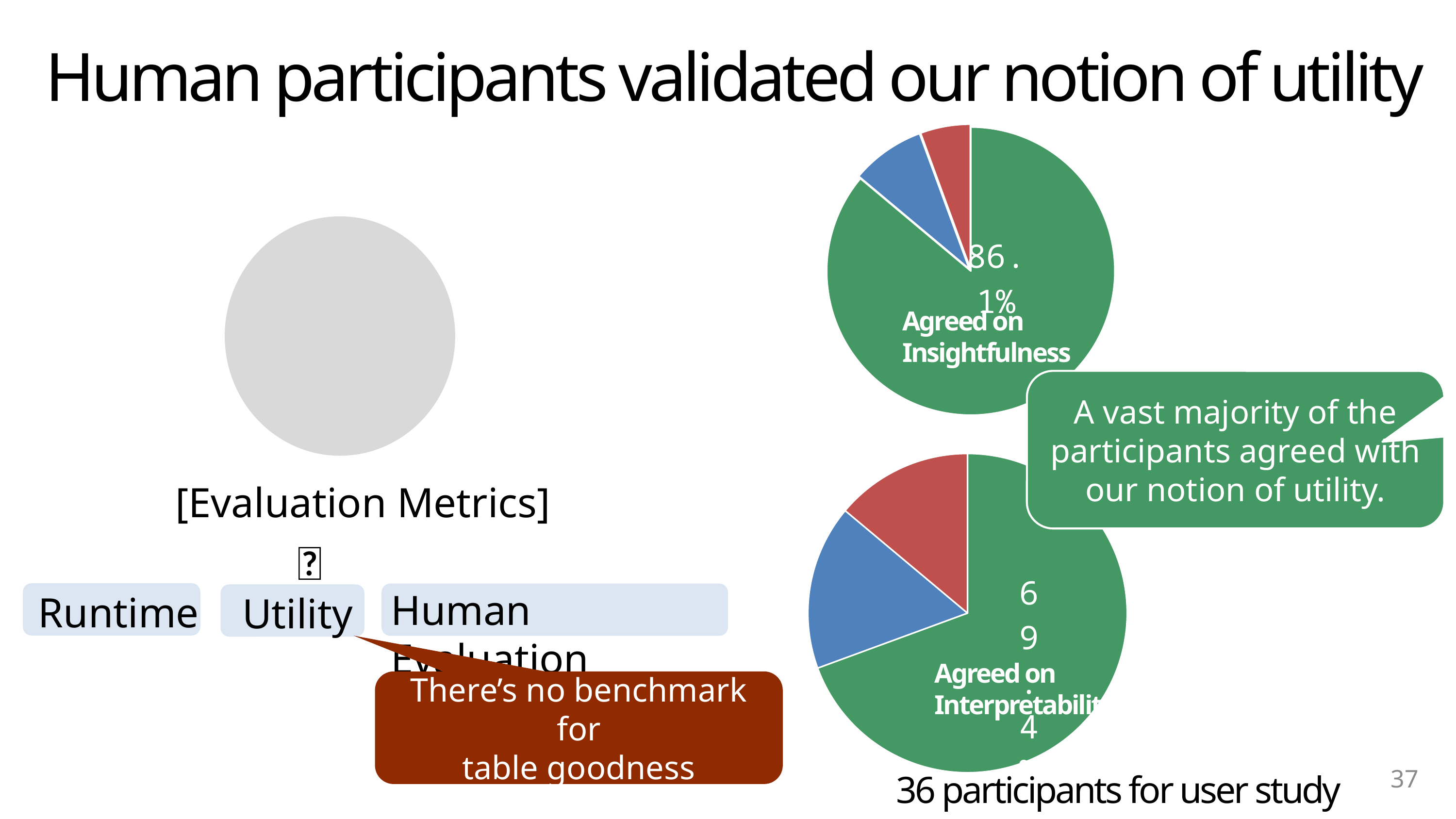
Which is larger: the agreed share in the 'Agreed on Insightfulness' chart or in the 'Agreed on Interpretability' chart? Agreed on Insightfulness How many slices does the 'Agreed on Insightfulness' pie chart have? 3 In the 'Agreed on Insightfulness' pie chart, which colour slice is the largest? Green According to the text below the pie charts, how many participants took part in the user study? 36 What kind of chart is the 'Agreed on Insightfulness' chart? Pie chart In the 'Agreed on Interpretability' pie chart, is the green slice greater or less than 50% of the pie? greater What kind of chart is the 'Agreed on Interpretability' chart? Pie chart In the 'Agreed on Insightfulness' pie chart, which colour slice is the smallest? Red In the 'Agreed on Insightfulness' pie chart, what percentage is shown for the green slice? 86.1% How many slices does the 'Agreed on Interpretability' pie chart have? 3 In the 'Agreed on Interpretability' pie chart, what percentage is shown for the green slice? 69.4% What is the difference between the agreed share for Insightfulness (86.1%) and for Interpretability (69.4%)? 16.7 percentage points